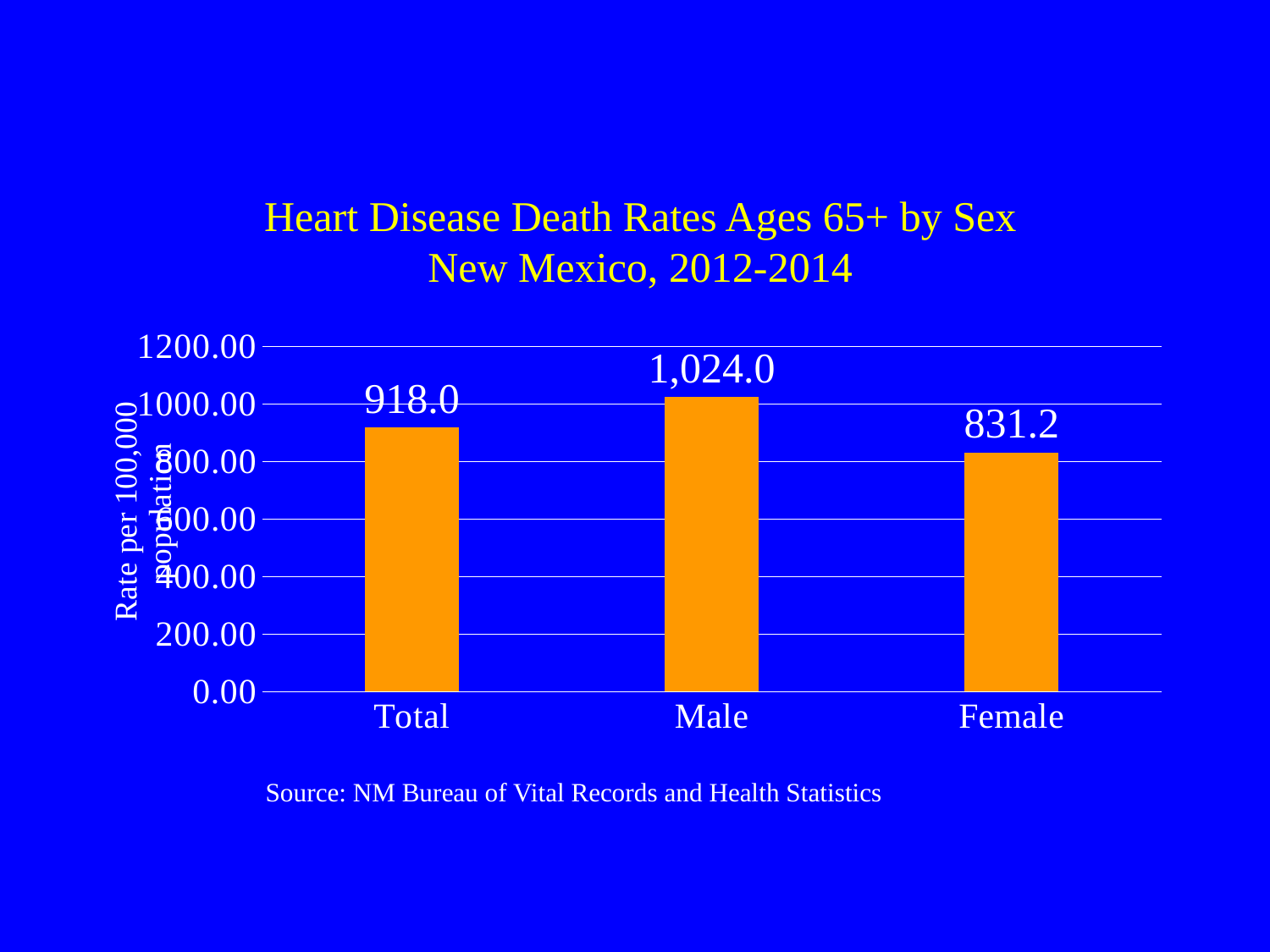
Which category has the highest death rate? Male What is the heart disease death rate for Male? 1,024.0 Is the value for Female greater or less than 1000.00? less What is the heart disease death rate for Total? 918.0 What kind of chart is shown on the slide? bar chart Which category has the lowest death rate? Female What is the title of the chart? Heart Disease Death Rates Ages 65+ by Sex New Mexico, 2012-2014 How many categories are shown on the x axis? 3 What is the heart disease death rate for Female? 831.2 What is the difference between the Male and Female death rates? 192.8 What is the difference between the Male and Total death rates? 106.0 Which is larger, the death rate for Male or for Female? Male